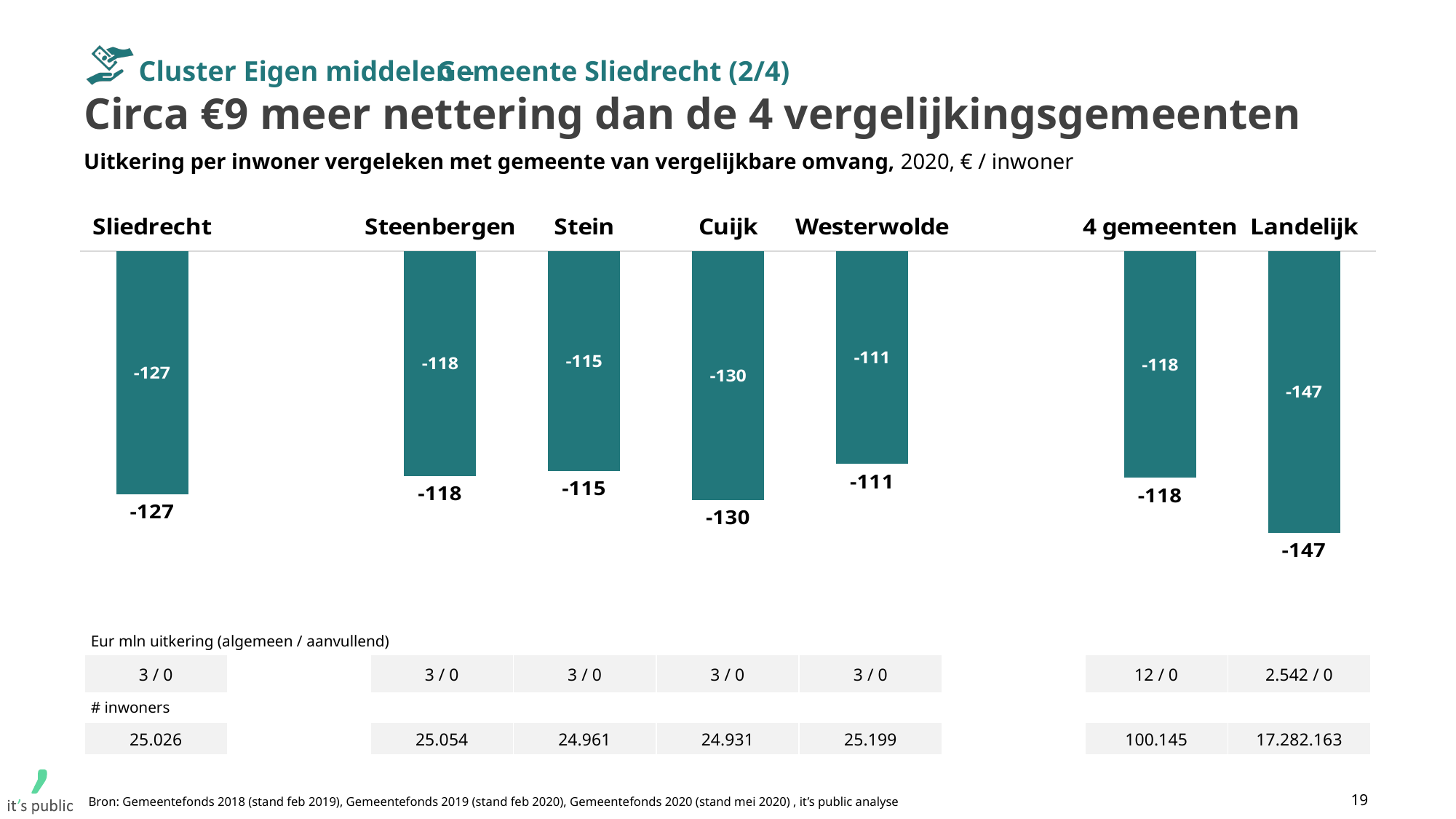
What is the value shown for Landelijk? -147 What kind of chart is shown on the slide? Bar chart Which category has the least negative value (the shortest bar)? Westerwolde Which bar extends further below zero, Cuijk or Stein? Cuijk Which category has the most negative value (the longest bar)? Landelijk What is the difference between the values for Sliedrecht and 4 gemeenten? 9 What is the value shown for Westerwolde? -111 How many bars are plotted in the chart? 7 What is the value shown for Sliedrecht? -127 What is the value shown for Cuijk? -130 What is the value shown for 4 gemeenten? -118 What is the difference between the values for Landelijk and Sliedrecht? 20